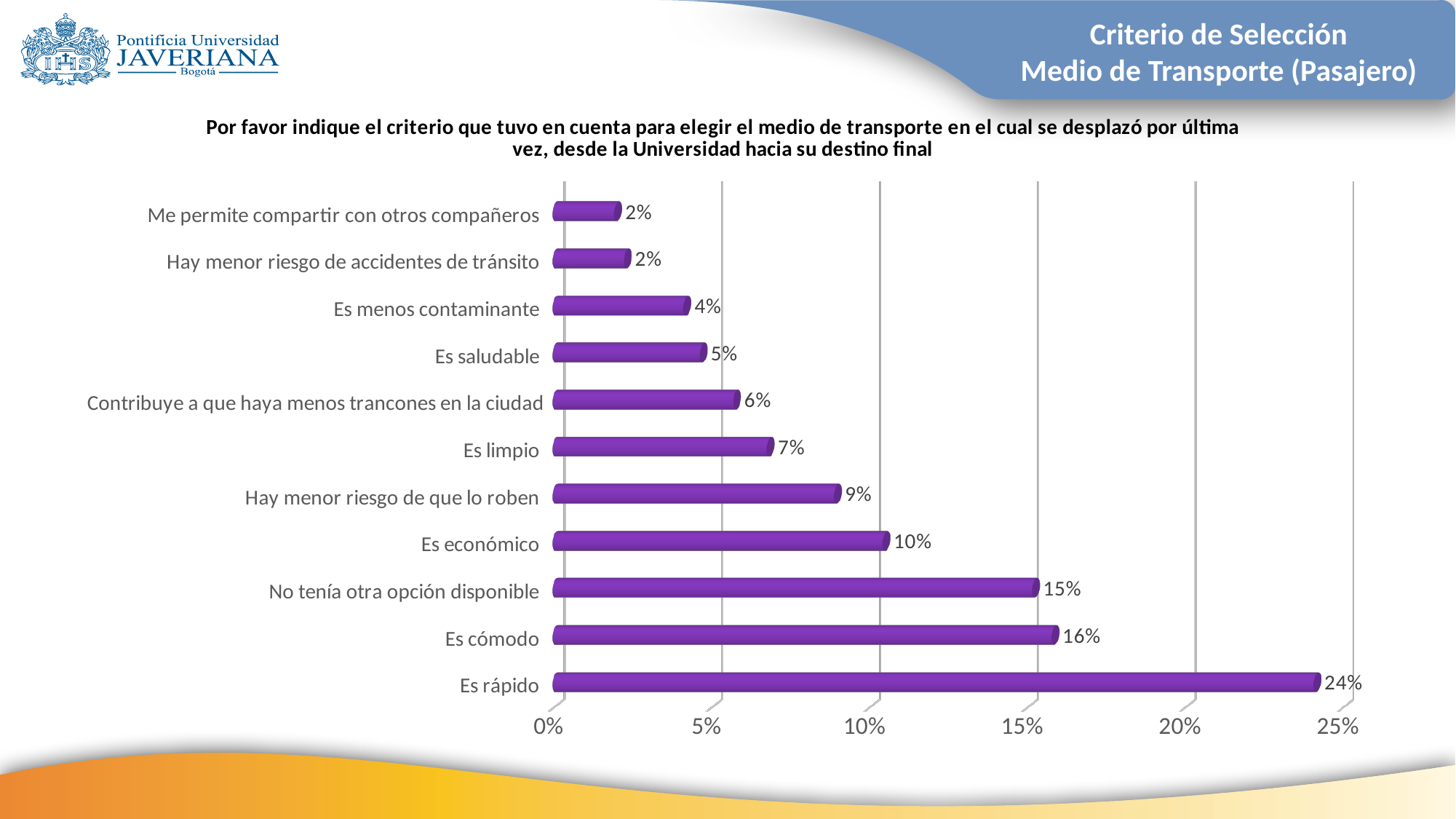
What is the value for "Es rápido"? 24% What is the maximum value shown on the horizontal axis? 25% What is the value for "Es limpio"? 7% What is the value for "No tenía otra opción disponible"? 15% How many categories are shown in the chart? 11 Which is larger, the value for "Es cómodo" or the value for "Es económico"? Es cómodo What is the value for "Es económico"? 10% Is the value for "Es rápido" greater or less than 20%? greater Which category has the highest value? Es rápido What is the difference between the values for "Es rápido" and "Es cómodo"? 8% What kind of chart is shown on the slide? Bar chart What is the difference between the values for "Hay menor riesgo de que lo roben" and "Es saludable"? 4%